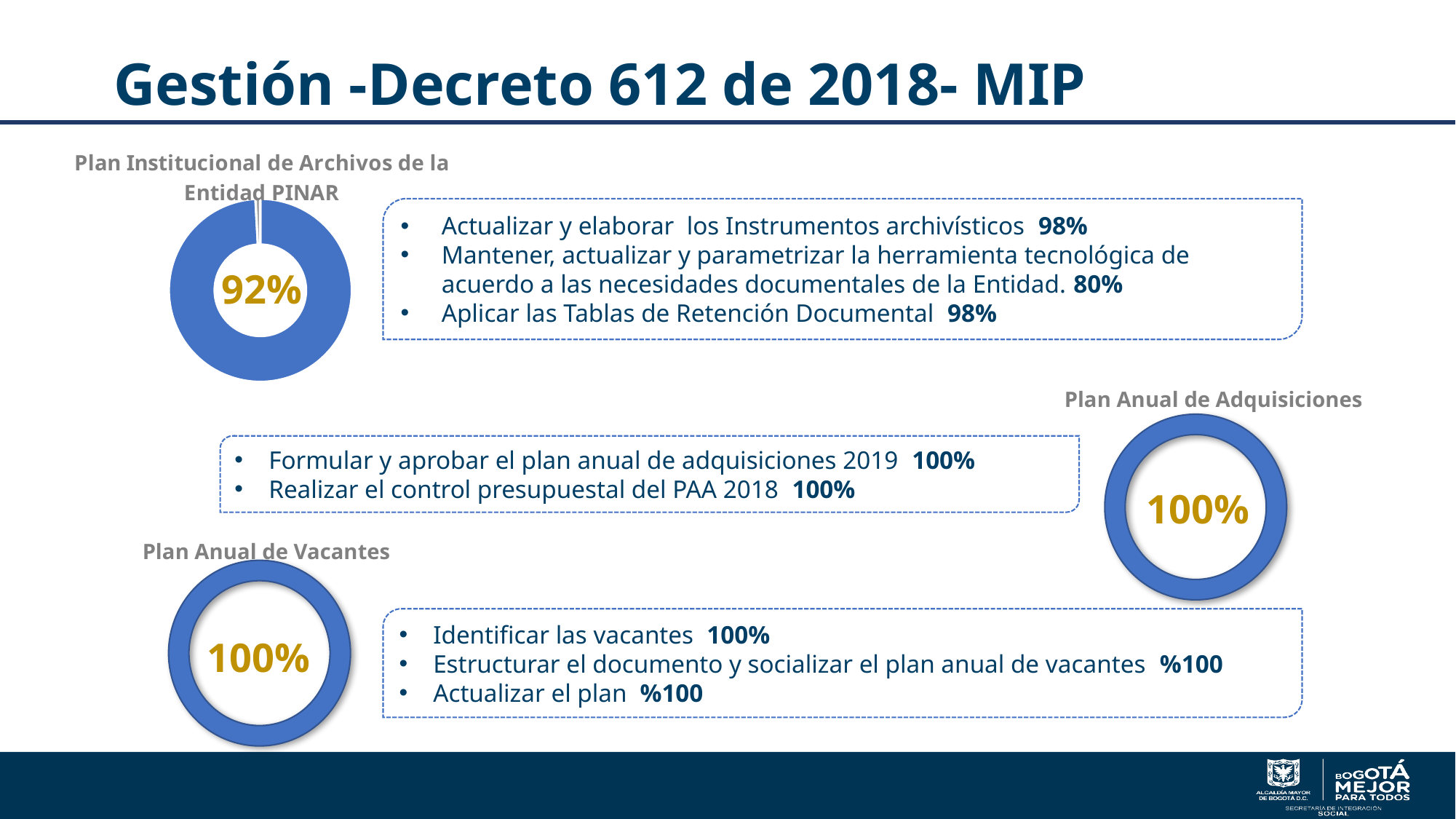
What is the title of the chart in the top-left of the slide? Plan Institucional de Archivos de la Entidad PINAR How many doughnut charts are on the slide? 1 Which of the three charts on the slide shows the lowest percentage? Plan Institucional de Archivos de la Entidad PINAR What colour is the filled ring of the doughnut charts on the slide? Blue What value is shown in the centre of the 'Plan Institucional de Archivos de la Entidad PINAR' chart? 92% What value is shown in the centre of the 'Plan Anual de Vacantes' chart? 100% What value is shown in the centre of the 'Plan Anual de Adquisiciones' chart? 100% Which is larger: the value in the 'Plan Anual de Adquisiciones' chart or the value in the 'Plan Institucional de Archivos de la Entidad PINAR' chart? Plan Anual de Adquisiciones What is the difference between the value in the 'Plan Anual de Adquisiciones' chart and the value in the 'Plan Institucional de Archivos de la Entidad PINAR' chart? 8 percentage points